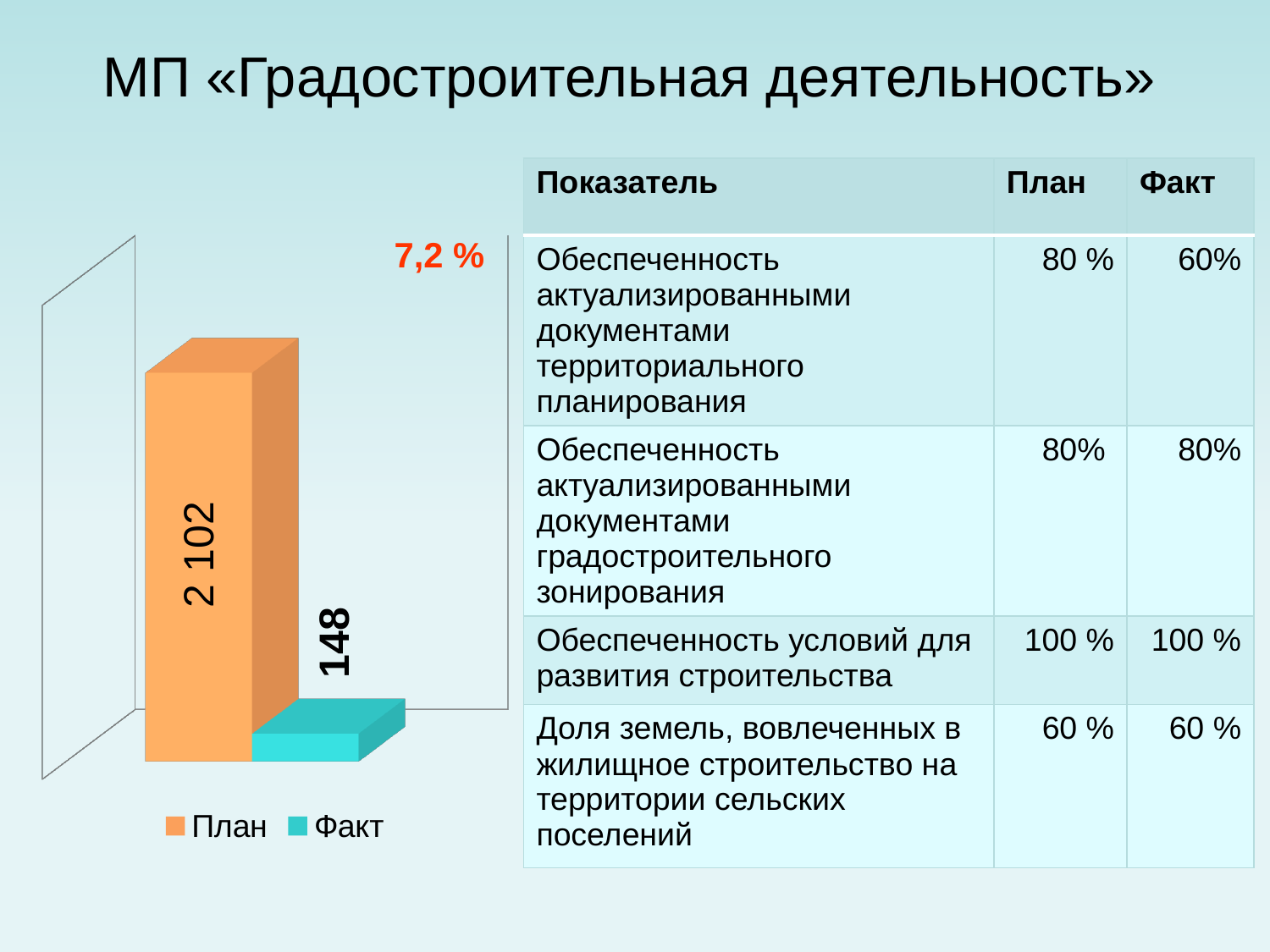
What colour is the Факт bar in the chart? Turquoise How many bars are plotted in the chart? 2 What percentage is printed in red above the chart? 7,2 % What kind of chart is shown on the slide? Bar chart Which series has the highest value in the chart? План What is the value of the План bar in the chart? 2 102 What is the value of the Факт bar in the chart? 148 Which bar in the chart is higher, План or Факт? План What is the difference between the План and Факт values in the chart? 1 954 How many series does the chart legend list? 2 Which series has the lowest value in the chart? Факт